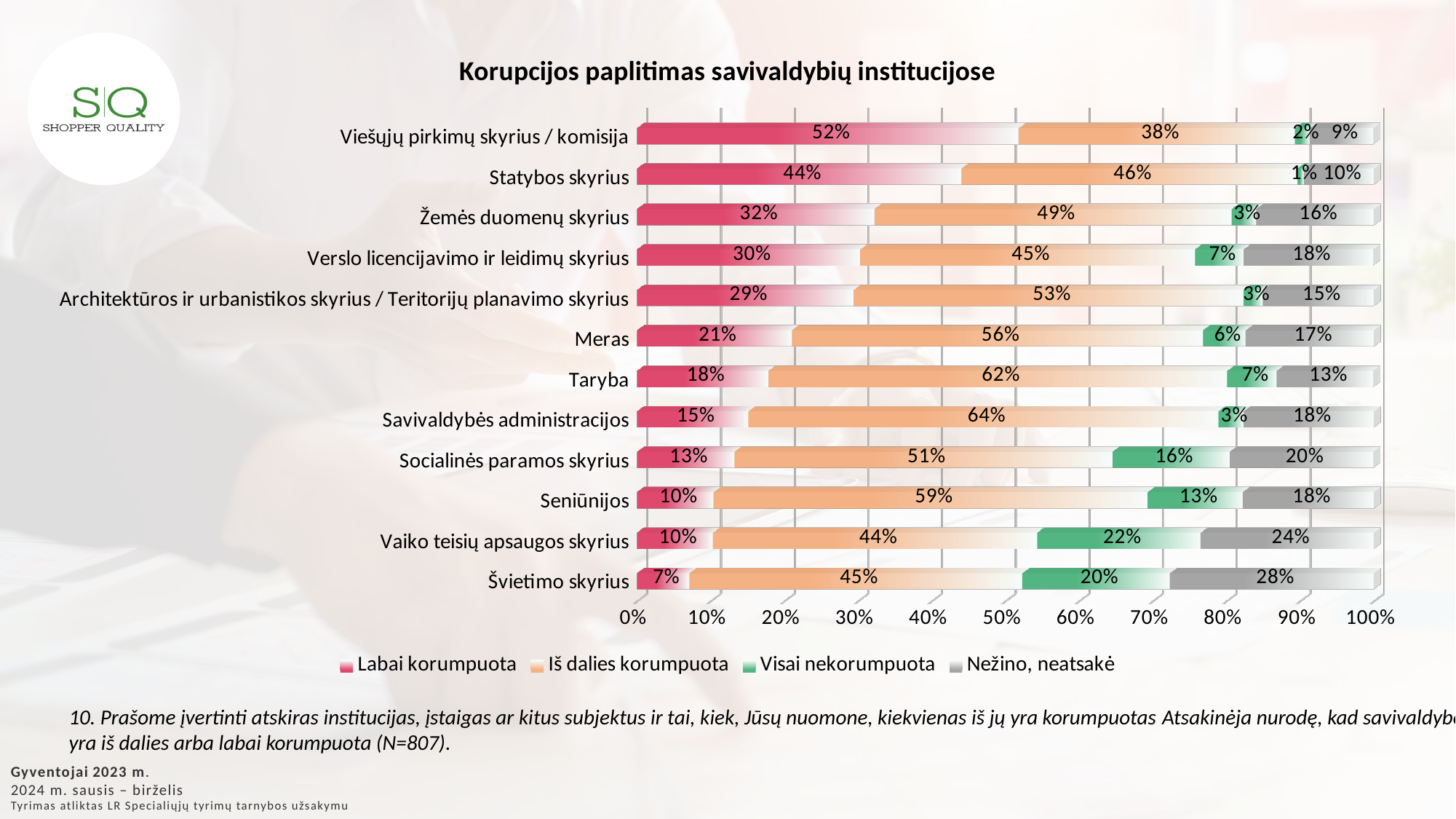
What is the total of the stacked bar for Meras? 100% What is the difference between the 'Labai korumpuota' values for Statybos skyrius and Meras? 23% Which institution has the highest 'Labai korumpuota' value? Viešųjų pirkimų skyrius / komisija Which is larger: the 'Iš dalies korumpuota' value for Taryba or for Seniūnijos? Taryba What is the 'Nežino, neatsakė' value for Švietimo skyrius? 28% Which institution has the lowest 'Labai korumpuota' value? Švietimo skyrius How many institutions (categories) are plotted in the chart? 12 How many series does the legend list? 4 What kind of chart is shown on the slide? Stacked bar chart What is the 'Iš dalies korumpuota' value for Savivaldybės administracijos? 64% What is the 'Visai nekorumpuota' value for Vaiko teisių apsaugos skyrius? 22% What is the 'Labai korumpuota' value for Viešųjų pirkimų skyrius / komisija? 52%